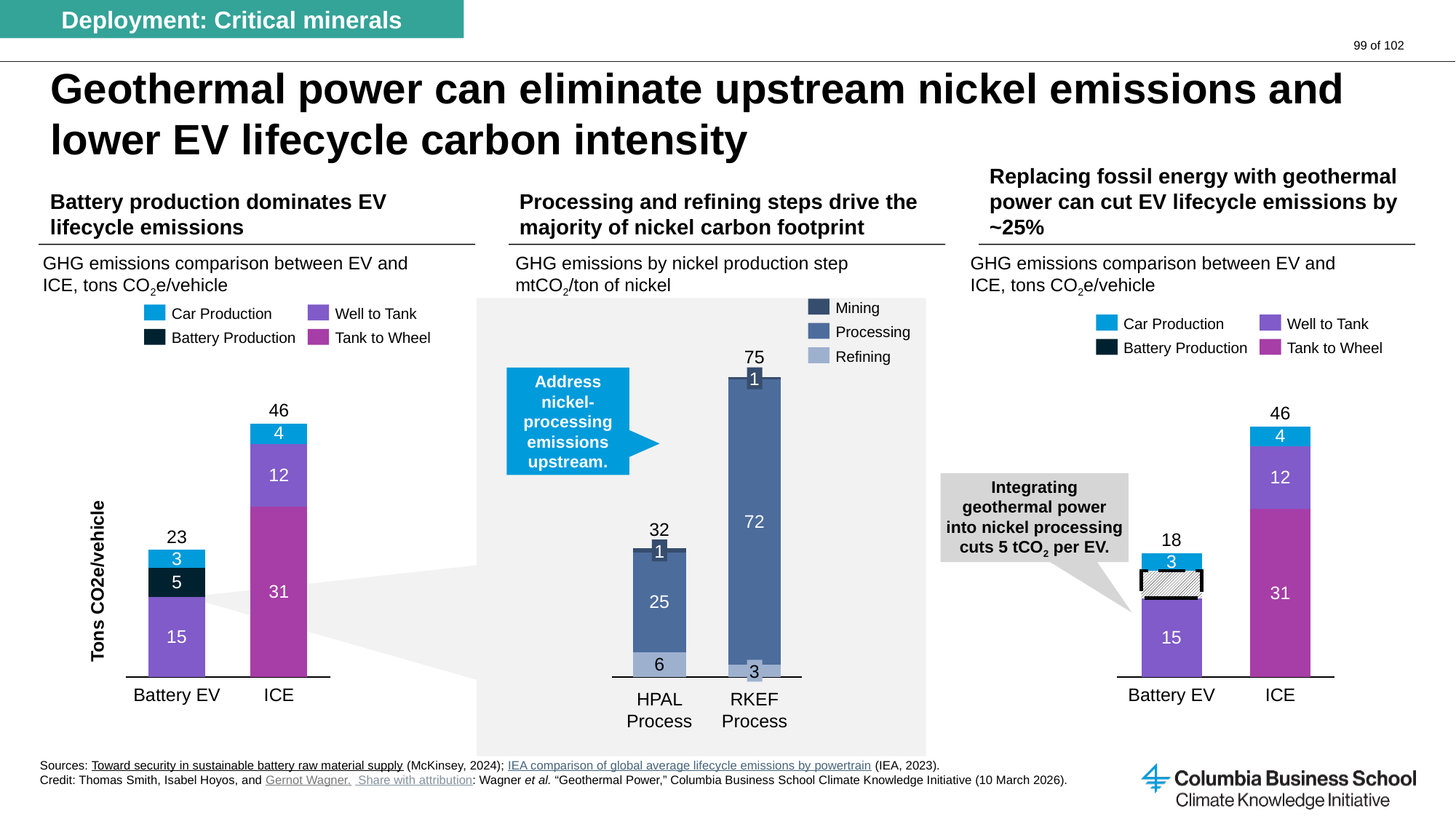
In the left chart, what is the difference between the ICE total and the Battery EV total? 23 In the right chart, what is the Well to Tank value for ICE? 12 In the left chart, what is the Tank to Wheel value for ICE? 31 In the middle chart, what is the difference between the RKEF Process total and the HPAL Process total? 43 In the left chart, what is the Battery Production value for Battery EV? 5 In the middle chart, which process has the higher total emissions? RKEF Process What type of chart is the left chart? Stacked bar chart In the left chart, what is the total for the Battery EV bar? 23 In the right chart, what is the total for the Battery EV bar? 18 In the middle chart, what is the Refining value for the HPAL Process? 6 How many series does the legend of the middle chart list? 3 In the middle chart, what is the Processing value for the RKEF Process? 72